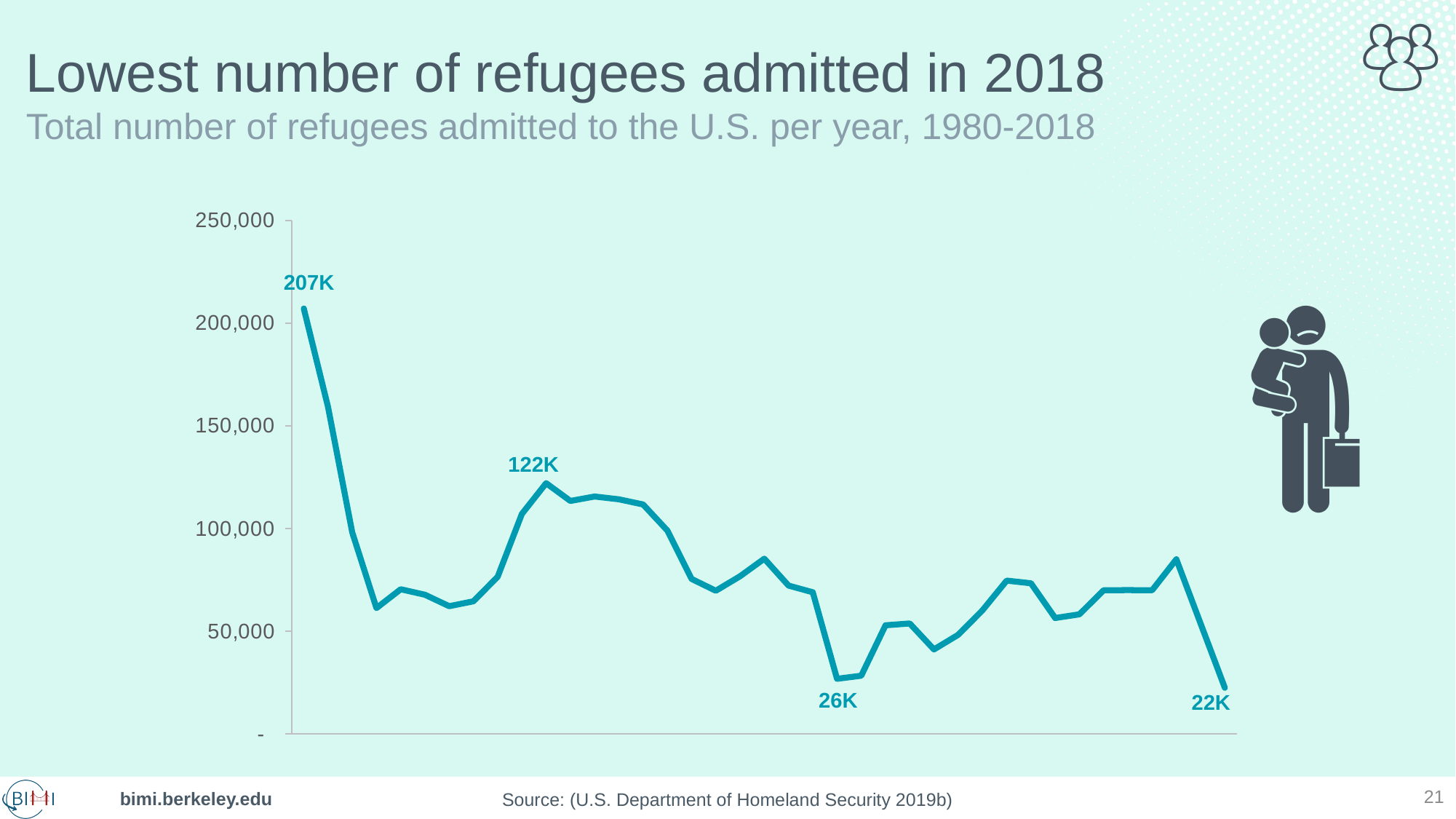
What is the value of the labeled trough in the middle of the line? 26K Which labeled value on the chart is the lowest? 22K Is the value at the last point of the line greater or less than 50,000? less What is the data label on the last point of the line (2018)? 22K What is the highest tick value shown on the vertical axis? 250,000 What is the difference between the first labeled value (207K) and the last labeled value (22K)? 185K What kind of chart is shown on the slide? line chart What is the value of the labeled peak in the middle-left part of the line? 122K What is the data label on the first point of the line (1980)? 207K Which is larger, the labeled peak of 122K or the first point of 207K? 207K Which labeled value on the chart is the highest? 207K Overall, does the line rise or fall from its first point to its last point? fall